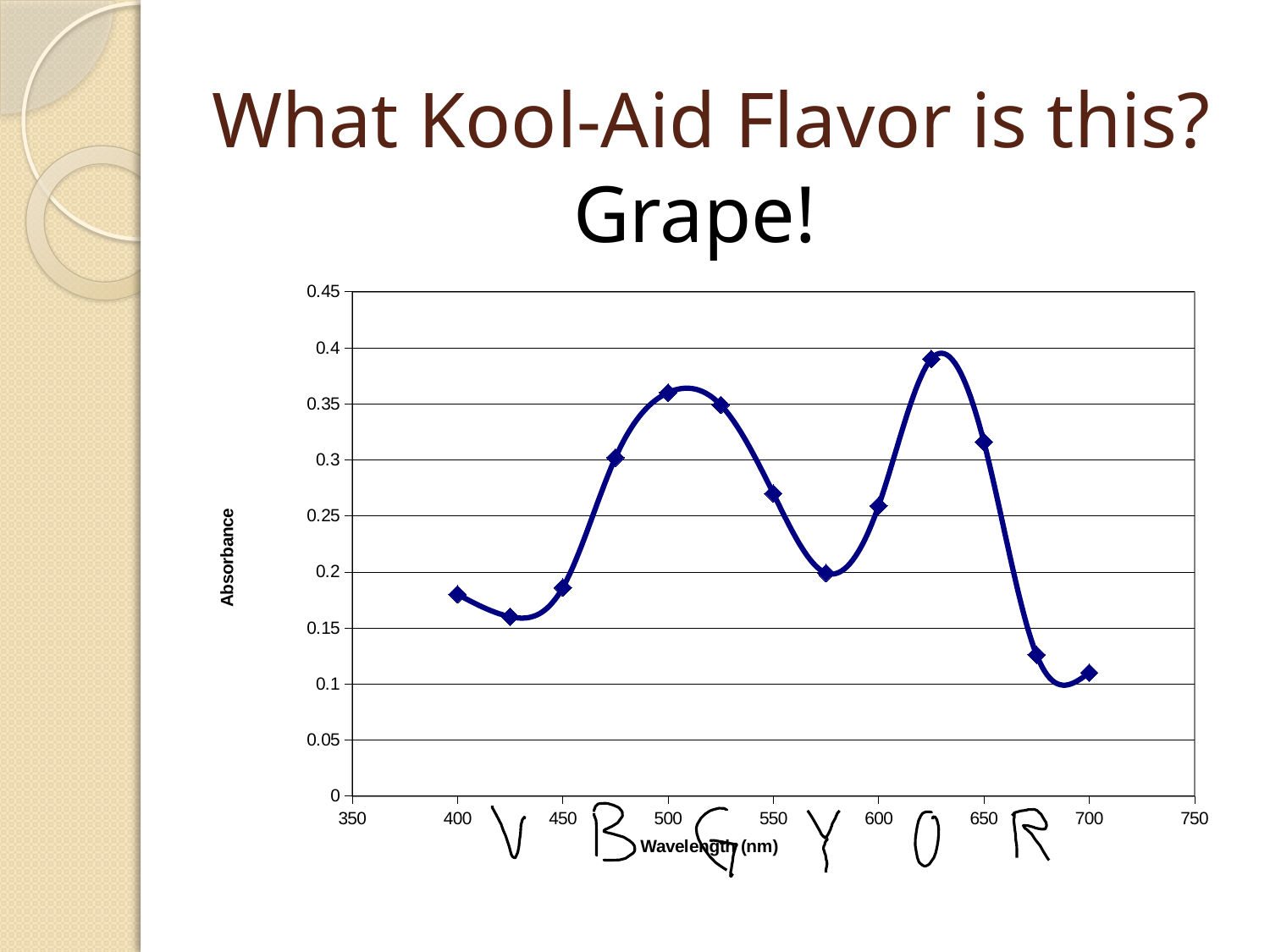
Is the absorbance at 400 nm greater or less than 0.2? less Does the absorbance rise or fall between 625 nm and 700 nm? fall At which wavelength is the absorbance highest? 625 Is the absorbance at 625 nm greater or less than 0.35? greater Is the absorbance at 575 nm greater or less than 0.25? less How many data points are plotted on the chart? 13 Which has the higher absorbance, 525 nm or 550 nm? 525 nm Which has the higher absorbance, 625 nm or 500 nm? 625 nm What is the label on the x axis of the chart? Wavelength (nm) What kind of chart is shown on the slide? line chart